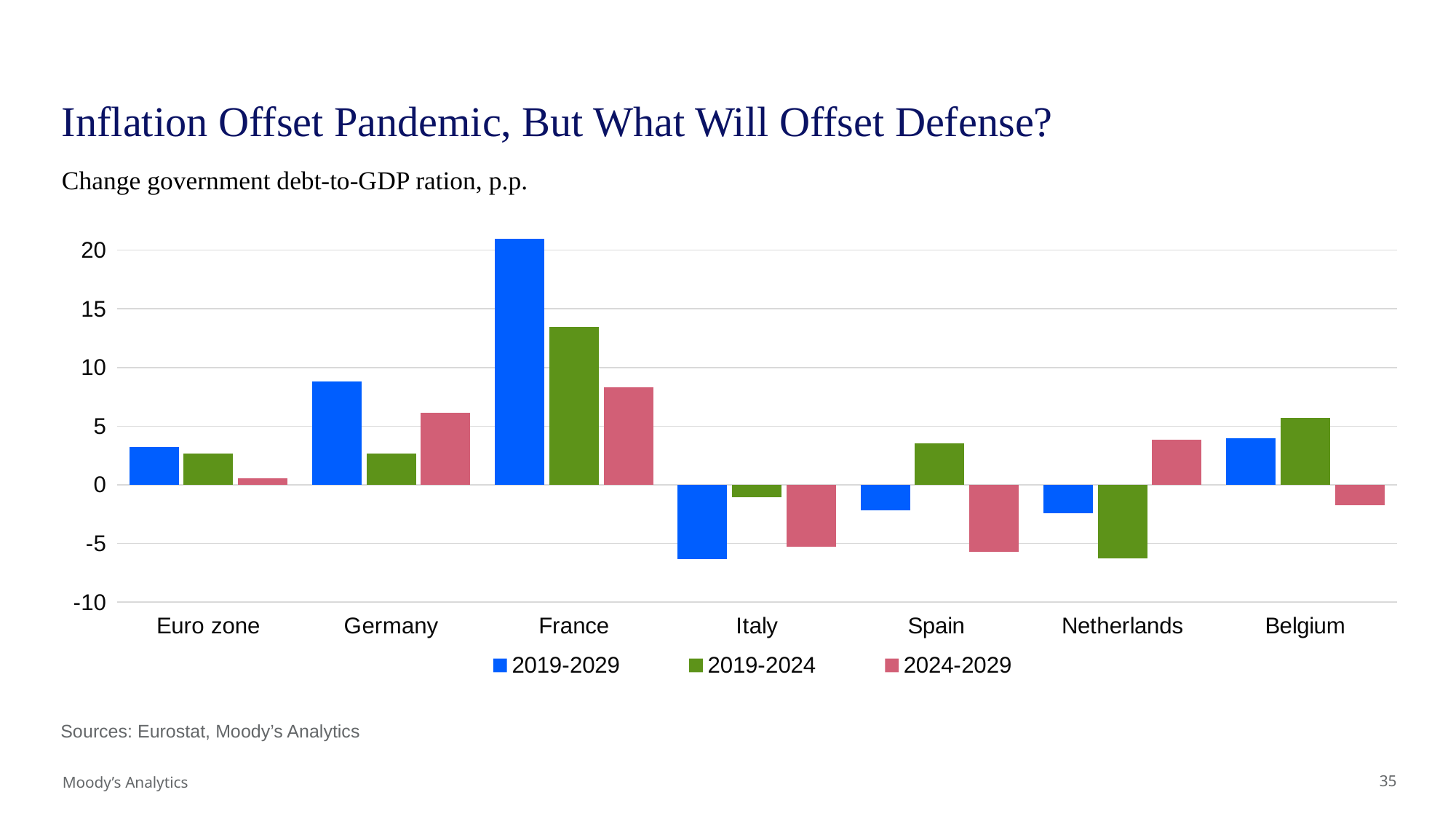
How many series does the legend list? 3 Which country has the lowest 2019-2029 value? Italy Which country has the highest 2019-2029 value? France Which country has the highest 2024-2029 value? France Which is larger, the 2019-2029 value for Germany or the 2019-2029 value for Belgium? Germany What kind of chart is shown on the slide? bar chart Is the 2019-2029 value for France greater or less than 20? greater Which country has the lowest 2019-2024 value? Netherlands Is the 2019-2024 value for the Netherlands greater or less than -5? less What are the three series listed in the legend? 2019-2029, 2019-2024, 2024-2029 How many countries or regions are shown on the x axis? 7 Is the 2019-2024 value for Germany greater or less than 5? less